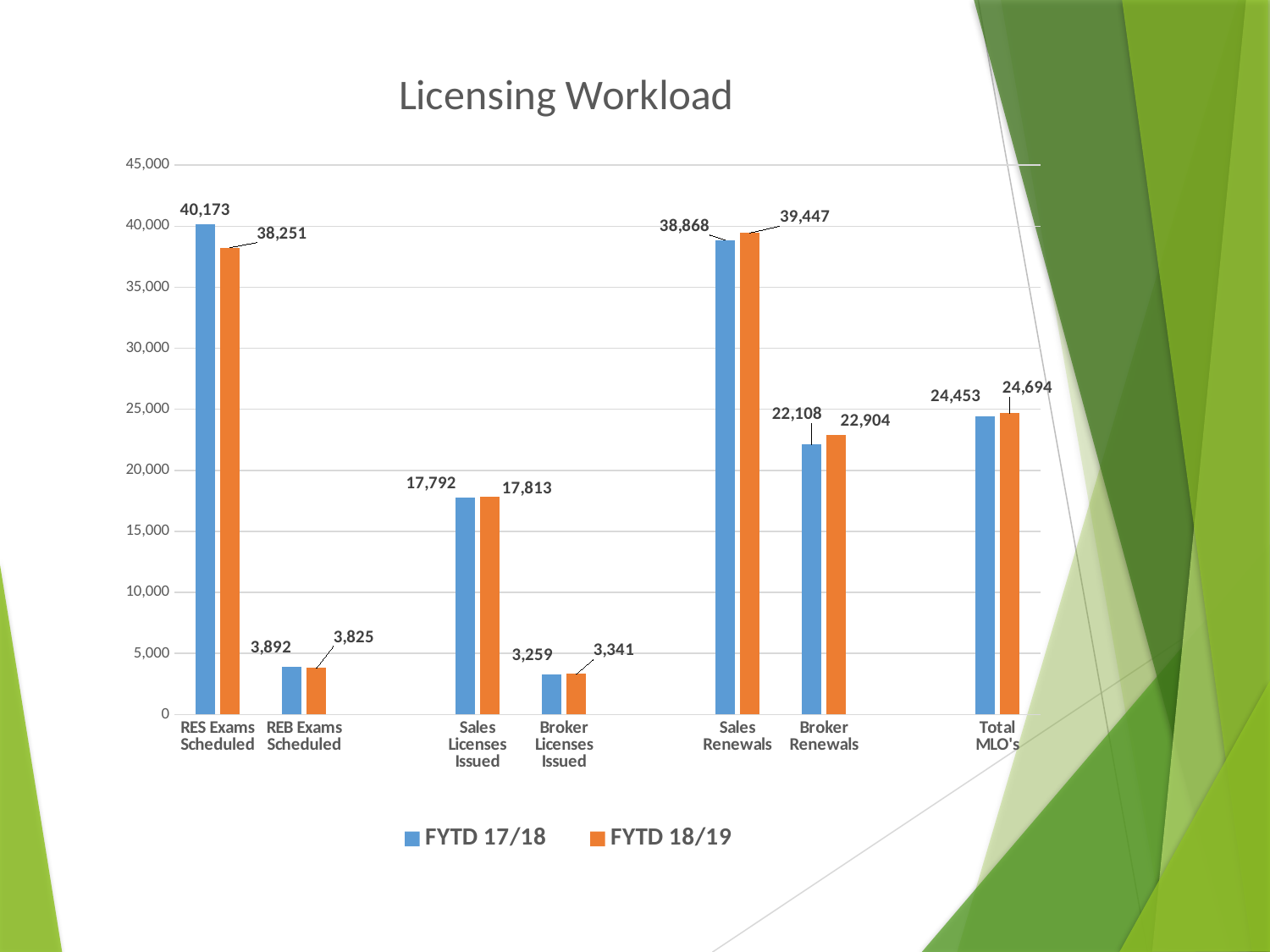
Which category has the highest FYTD 17/18 value? RES Exams Scheduled Which category has the lowest FYTD 18/19 value? Broker Licenses Issued How many categories are shown on the x axis? 7 How many series does the legend list? 2 What is the FYTD 18/19 value for Broker Licenses Issued? 3,341 What is the FYTD 18/19 value for Sales Renewals? 39,447 What is the difference between the FYTD 17/18 and FYTD 18/19 values for RES Exams Scheduled? 1,922 For Sales Renewals, which is larger: the FYTD 17/18 value or the FYTD 18/19 value? FYTD 18/19 What is the FYTD 17/18 value for Total MLO's? 24,453 What is the difference between the FYTD 18/19 and FYTD 17/18 values for Broker Renewals? 796 What is the FYTD 17/18 value for RES Exams Scheduled? 40,173 What type of chart is shown on the slide? Bar chart